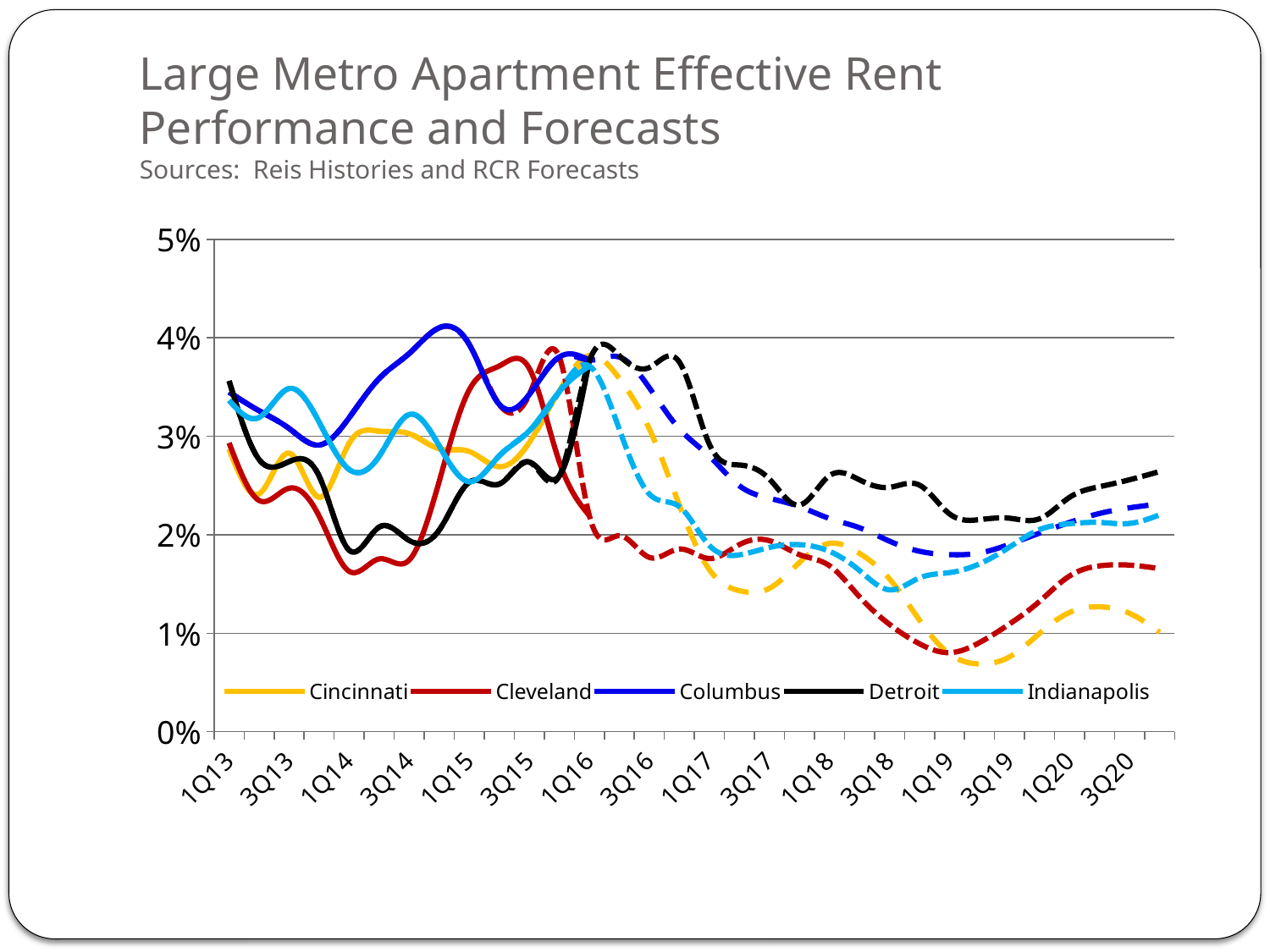
What kind of chart is shown on the slide? line chart How many series does the legend list? 5 At 1Q19, which is larger, the value for Detroit or the value for Cleveland? Detroit Does the Cleveland series rise or fall from 1Q16 to 1Q19? fall Which series has the highest value at 1Q15? Columbus Which metros are listed in the legend? Cincinnati, Cleveland, Columbus, Detroit, Indianapolis Is the value for Detroit at 3Q20 greater or less than 2%? greater Is the value for Cleveland at 1Q19 greater or less than 1%? less What sources are cited under the chart title? Reis Histories and RCR Forecasts Is the value for Cleveland at 1Q14 greater or less than 2%? less